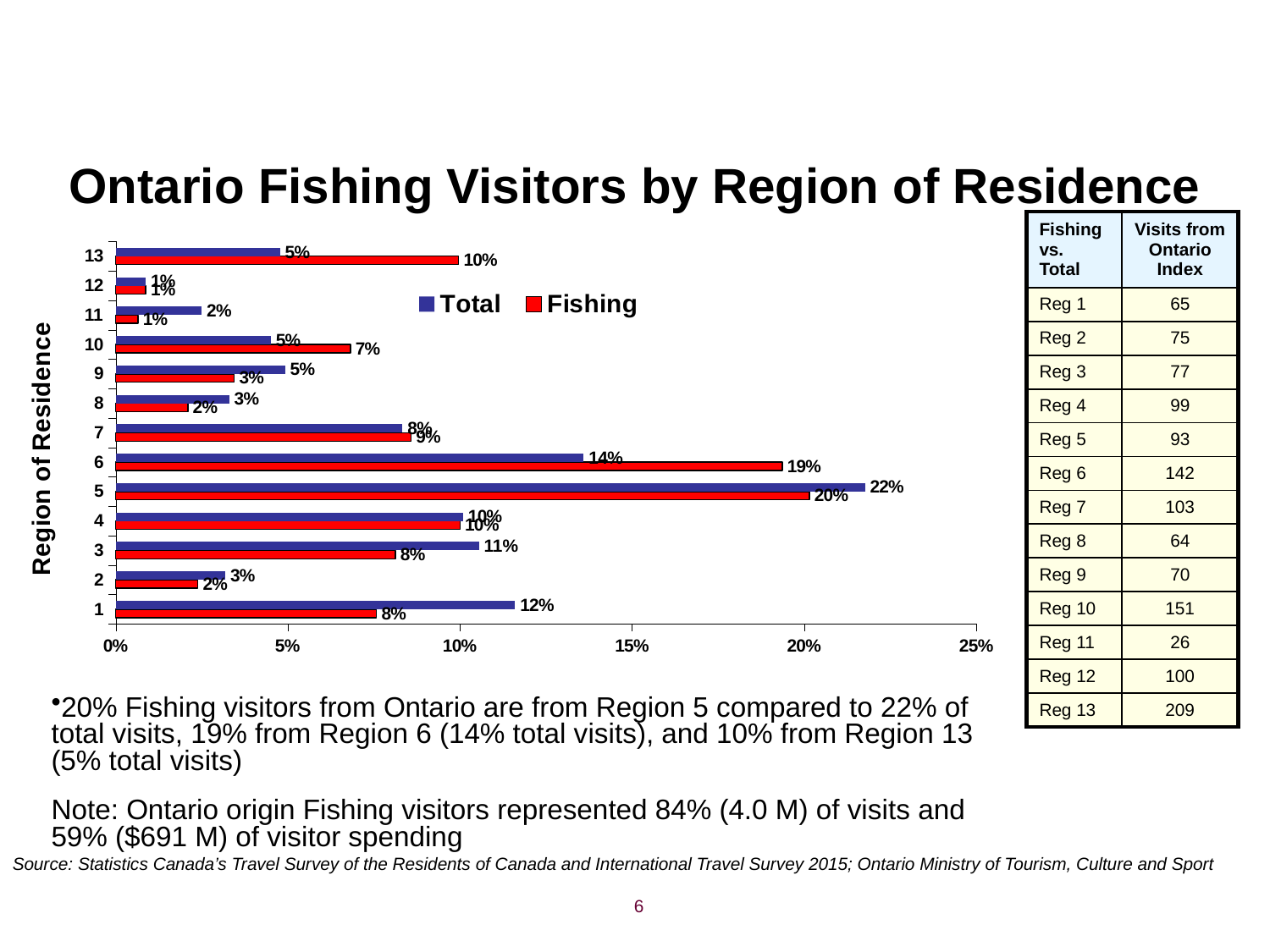
Which region has the highest Fishing value? Region 5 What is the Total value for Region 1? 12% Which region has the highest Total value? Region 5 What is the Fishing value for Region 5? 20% What is the Total value for Region 6? 14% What is the Fishing value for Region 13? 10% How many series does the legend list? 2 What type of chart is shown? Bar chart What is the difference between the Total and Fishing values for Region 1? 4% For Region 13, which is larger: the Total value or the Fishing value? Fishing What is the difference between the Fishing and Total values for Region 6? 5% How many regions are shown on the chart? 13